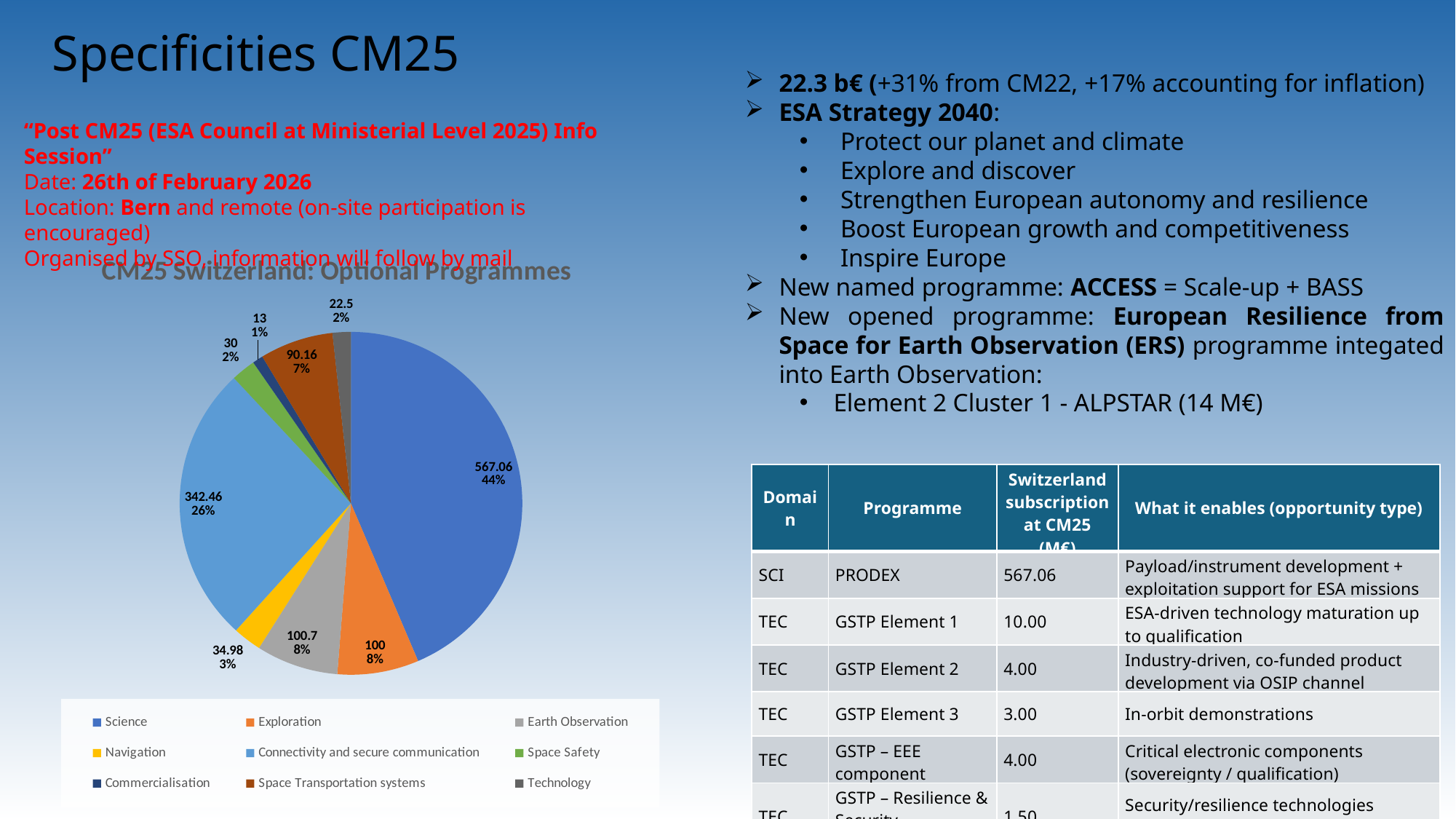
What is the value shown for Space Transportation systems in the pie chart? 90.16 How many categories does the legend of the pie chart list? 9 Which category has the smallest slice in the pie chart? Commercialisation What colour is used for the Exploration slice in the pie chart? orange Which is larger in the pie chart, the value for Navigation or the value for Space Safety? Navigation What is the difference between the values for Science and Connectivity and secure communication? 224.6 What is the value shown for Science in the pie chart? 567.06 What type of chart is shown on the slide? pie chart What share of the pie does Connectivity and secure communication represent? 26% What is the title of the chart on the slide? CM25 Switzerland: Optional Programmes What percentage share is shown for Technology in the pie chart? 2% Which category has the largest slice in the pie chart? Science